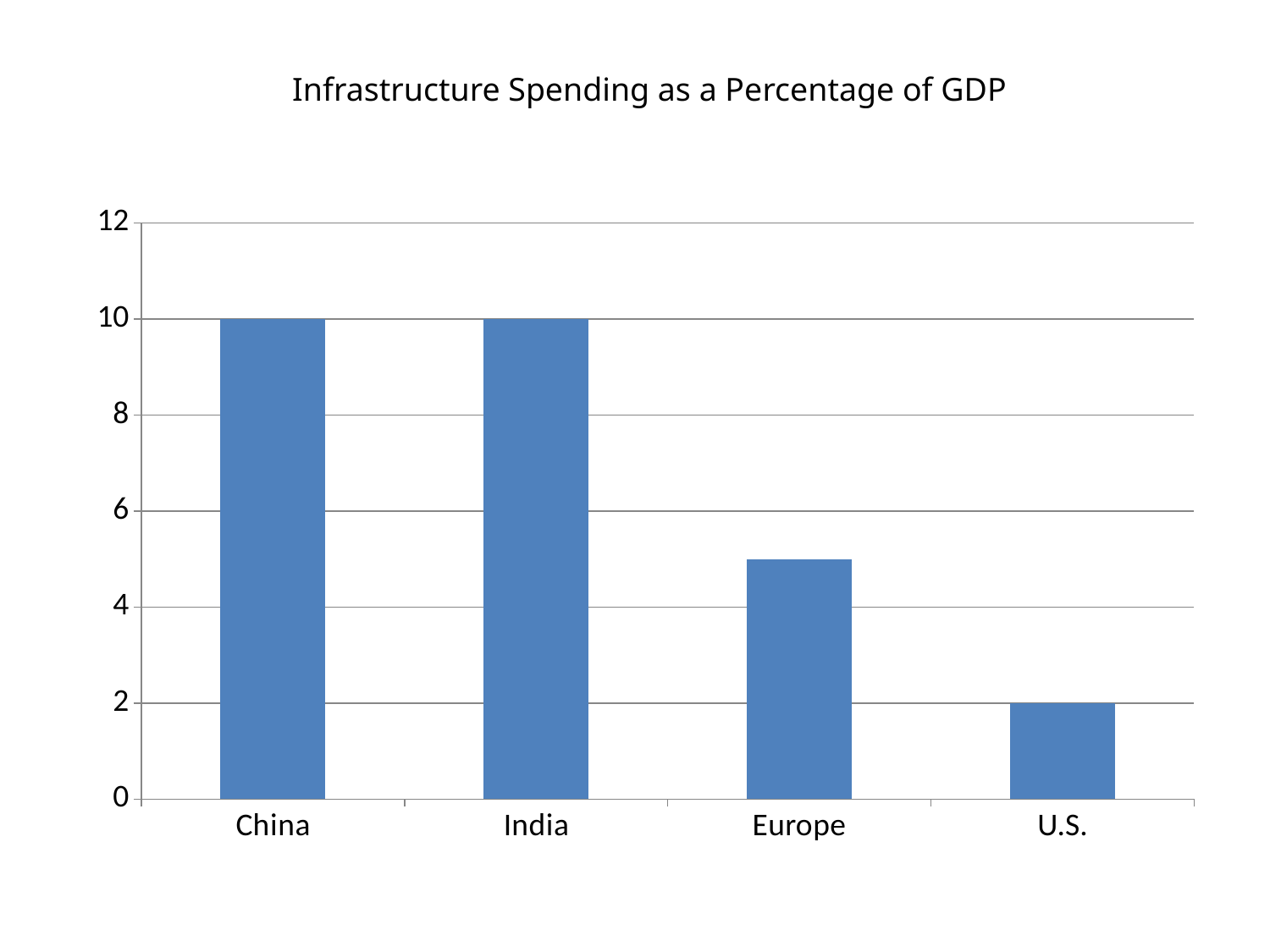
What is the value for U.S.? 2 Which category has the lowest value? U.S. How many categories are shown on the x axis? 4 What is the value for China? 10 Do the values rise or fall from left to right along the x axis? fall What is the value for India? 10 What is the difference between the values for China and U.S.? 8 Is the value for Europe greater or less than 4? greater What is the title of the chart? Infrastructure Spending as a Percentage of GDP What kind of chart is shown on the slide? bar chart Which is larger, the value for India or the value for Europe? India Is the value for Europe greater or less than 6? less